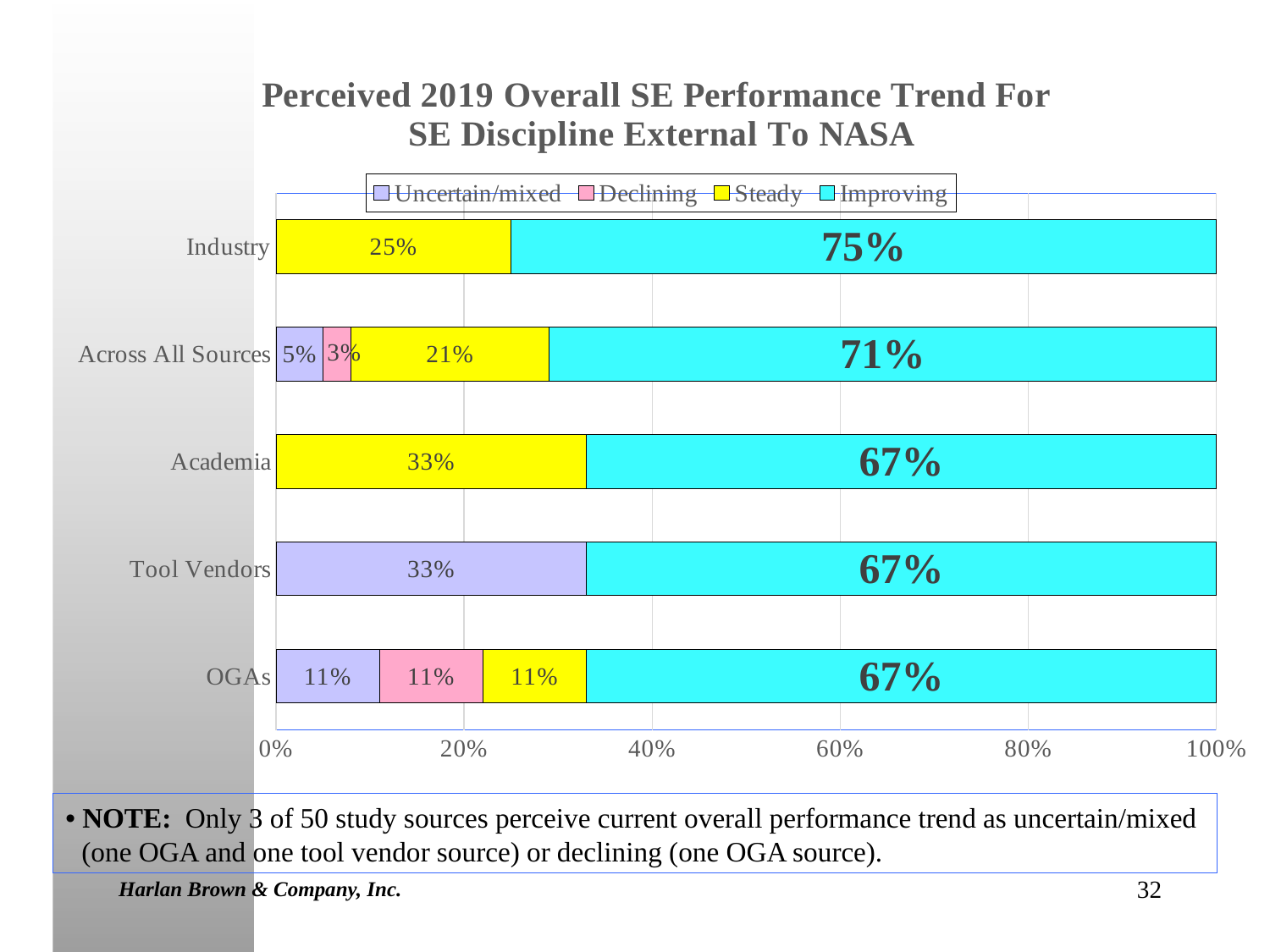
What is the Improving value for Industry? 75% What kind of chart is shown on the slide? Stacked bar chart What is the Declining value for OGAs? 11% Which is larger, the Steady value for Academia or the Steady value for Industry? Academia What is the Uncertain/mixed value for Tool Vendors? 33% How many categories are shown on the y axis? 5 Which legend entry is shown in yellow? Steady What is the total of the Uncertain/mixed, Declining and Steady segments for OGAs? 33% What is the Steady value for Across All Sources? 21% Which category has the highest Improving value? Industry How many series does the legend list? 4 What is the difference between the Improving values for Industry and Across All Sources? 4%